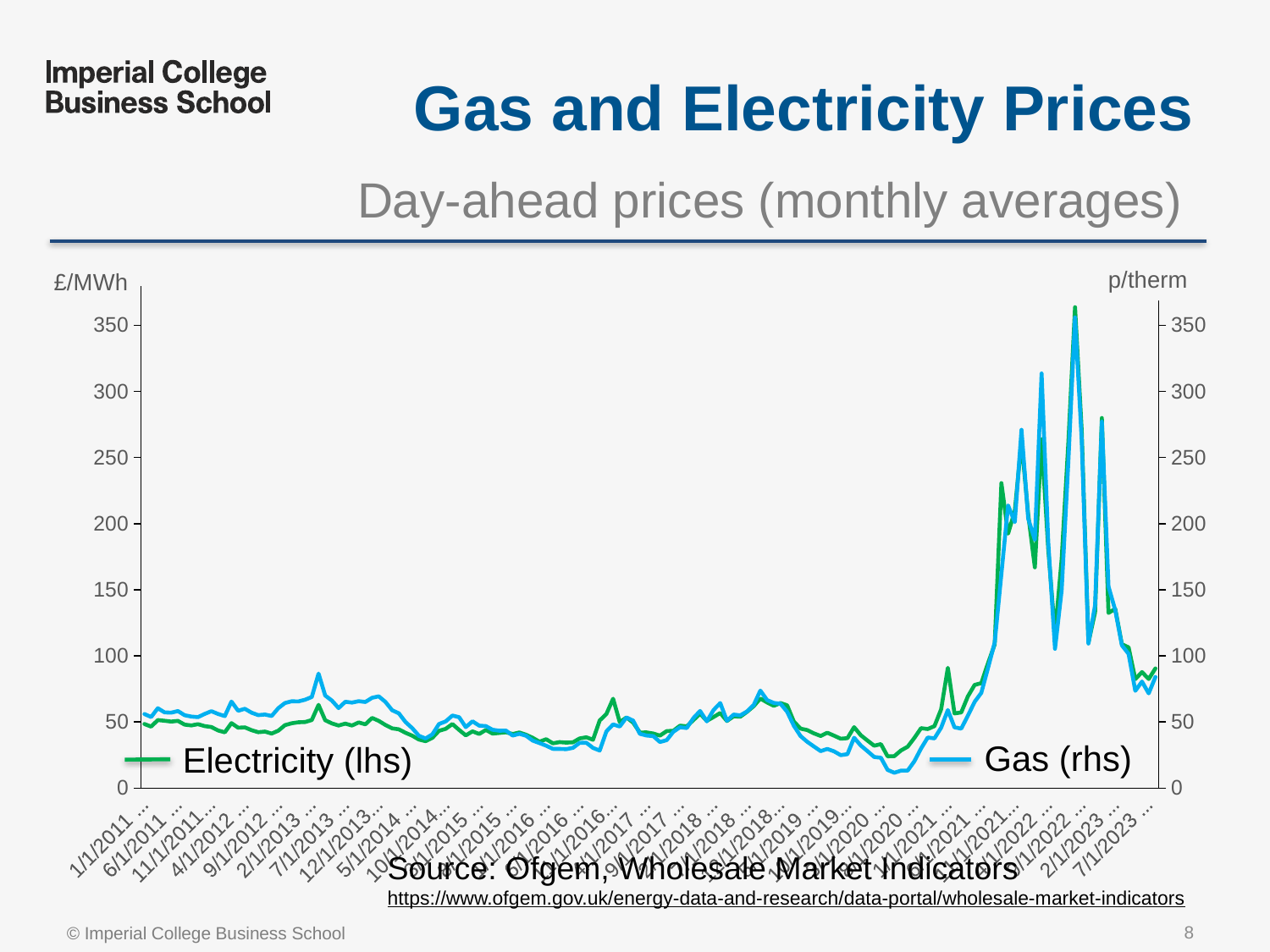
Is the peak value of the Gas (rhs) series greater or less than 300? greater How many series does the chart's legend list? 2 Is the Electricity (lhs) value at 1/1/2011 greater or less than 100? less Is the Gas (rhs) value around mid-2020 greater or less than 50? less Do the Gas (rhs) values generally rise or fall between early 2019 and mid-2020? fall What kind of chart is shown on the slide? line chart What are the two series named in the legend? Electricity (lhs) and Gas (rhs) Do the Electricity (lhs) values generally rise or fall between mid-2020 and early 2022? rise What unit is shown on the left-hand axis of the chart? £/MWh